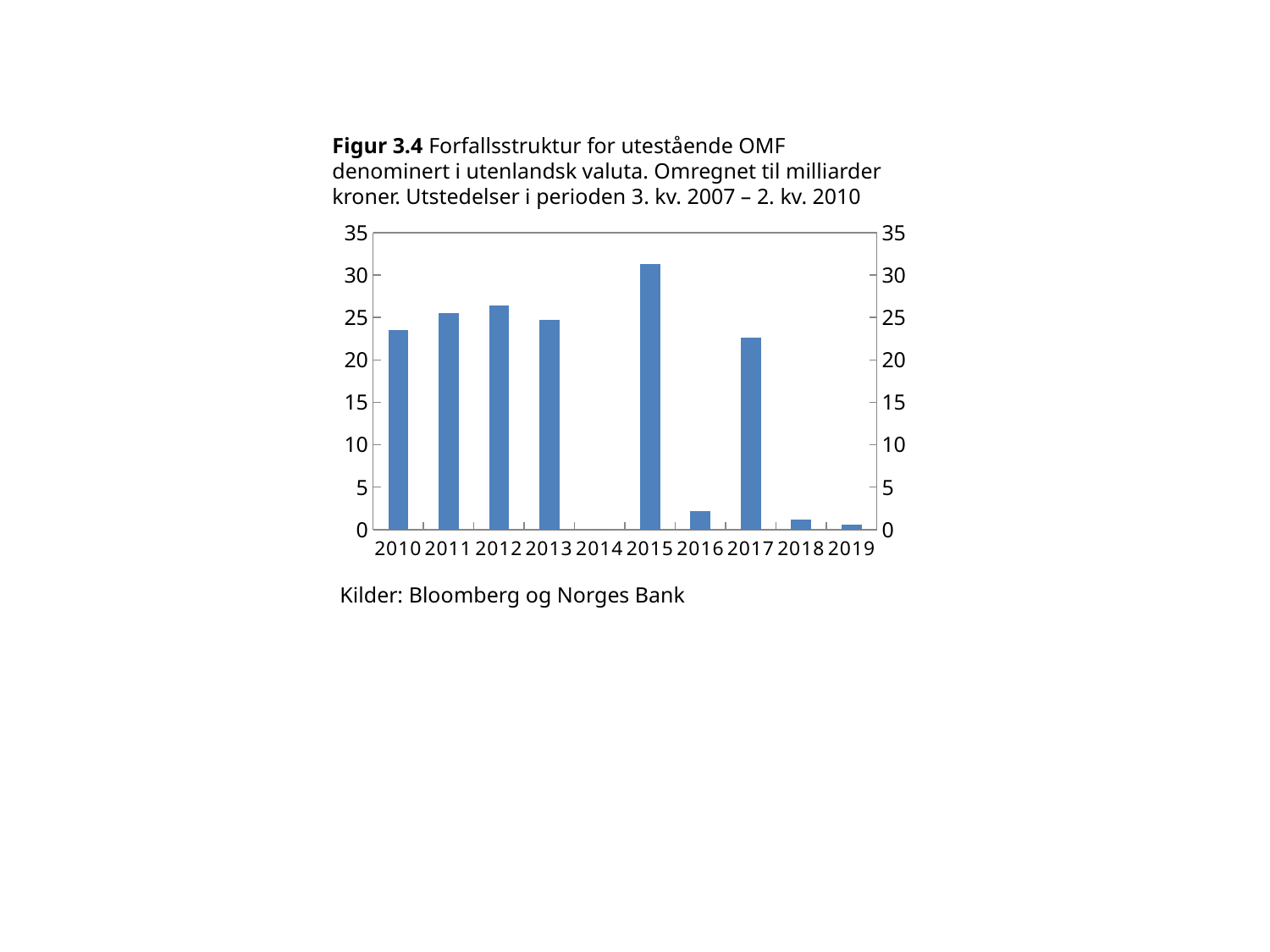
Which is larger, the value for 2012 or the value for 2010? 2012 What kind of chart is shown on the slide? bar chart Is the value for 2016 greater or less than 5? less Is the value for 2010 greater or less than 20? greater Which year has the highest value in the chart? 2015 What sources are cited below the chart? Bloomberg og Norges Bank Which is larger, the value for 2015 or the value for 2017? 2015 Is the value for 2018 greater or less than 5? less How many years are shown on the x axis of the chart? 10